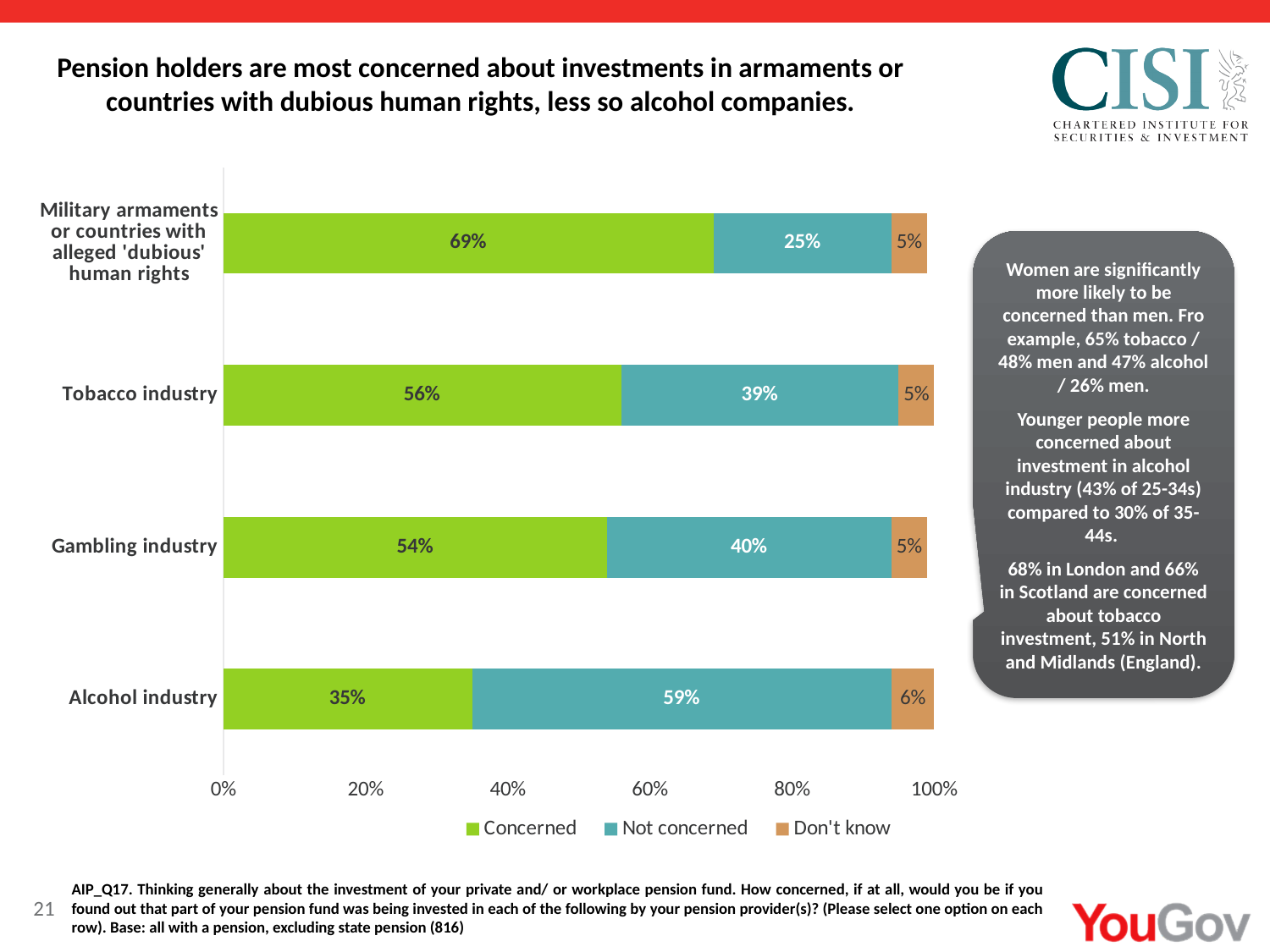
Which is larger: the 'Not concerned' share for the gambling industry or for the tobacco industry? Gambling industry How many categories are shown on the chart? 4 What is the 'Don't know' value for the alcohol industry? 6% Which category has the highest 'Concerned' percentage? Military armaments or countries with alleged 'dubious' human rights What kind of chart is shown on the slide? Stacked bar chart Is the 'Concerned' value for the gambling industry greater or less than 40%? greater What is the difference between the 'Concerned' percentages for the tobacco industry and the alcohol industry? 21% How many series does the legend list? 3 What percentage are not concerned about investment in the alcohol industry? 59% What percentage of pension holders are concerned about investment in the tobacco industry? 56% Which category has the lowest 'Concerned' percentage? Alcohol industry Which colour represents the 'Not concerned' series in the legend? Teal